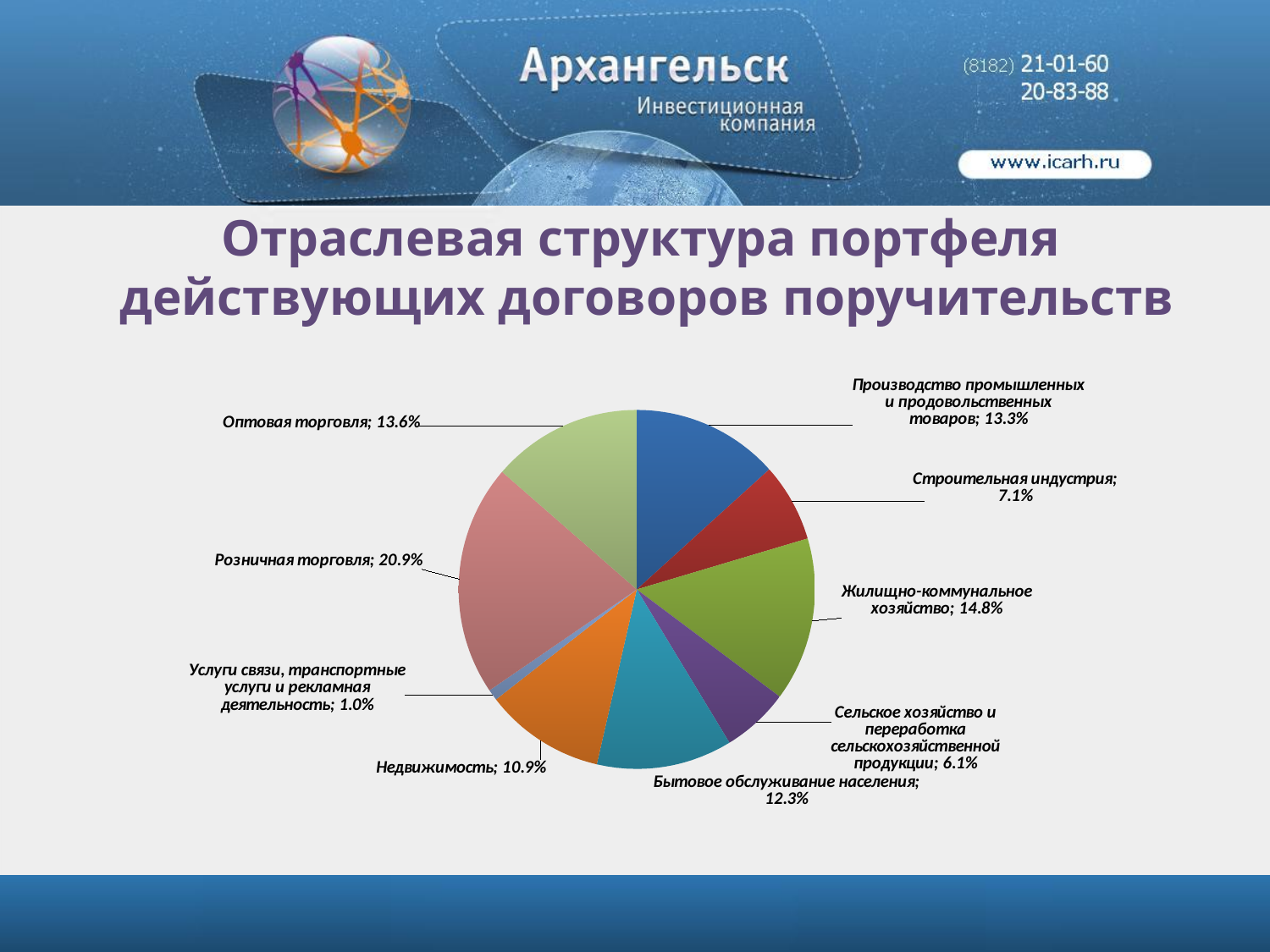
Which category has the smallest share of the pie? Услуги связи, транспортные услуги и рекламная деятельность Which category has the largest share of the pie? Розничная торговля What is the value shown for Жилищно-коммунальное хозяйство? 14.8% How many slices does the pie chart have? 9 What percentage is shown for Услуги связи, транспортные услуги и рекламная деятельность? 1.0% What is the value for Недвижимость? 10.9% What is the difference between the shares of Оптовая торговля and Строительная индустрия? 6.5% What is the combined share of Оптовая торговля and Розничная торговля? 34.5% What share does Розничная торговля have in the pie chart? 20.9% What kind of chart is shown on the slide? Pie chart What is the title of the slide's chart? Отраслевая структура портфеля действующих договоров поручительств Which is larger: the share of Бытовое обслуживание населения or the share of Сельское хозяйство и переработка сельскохозяйственной продукции? Бытовое обслуживание населения